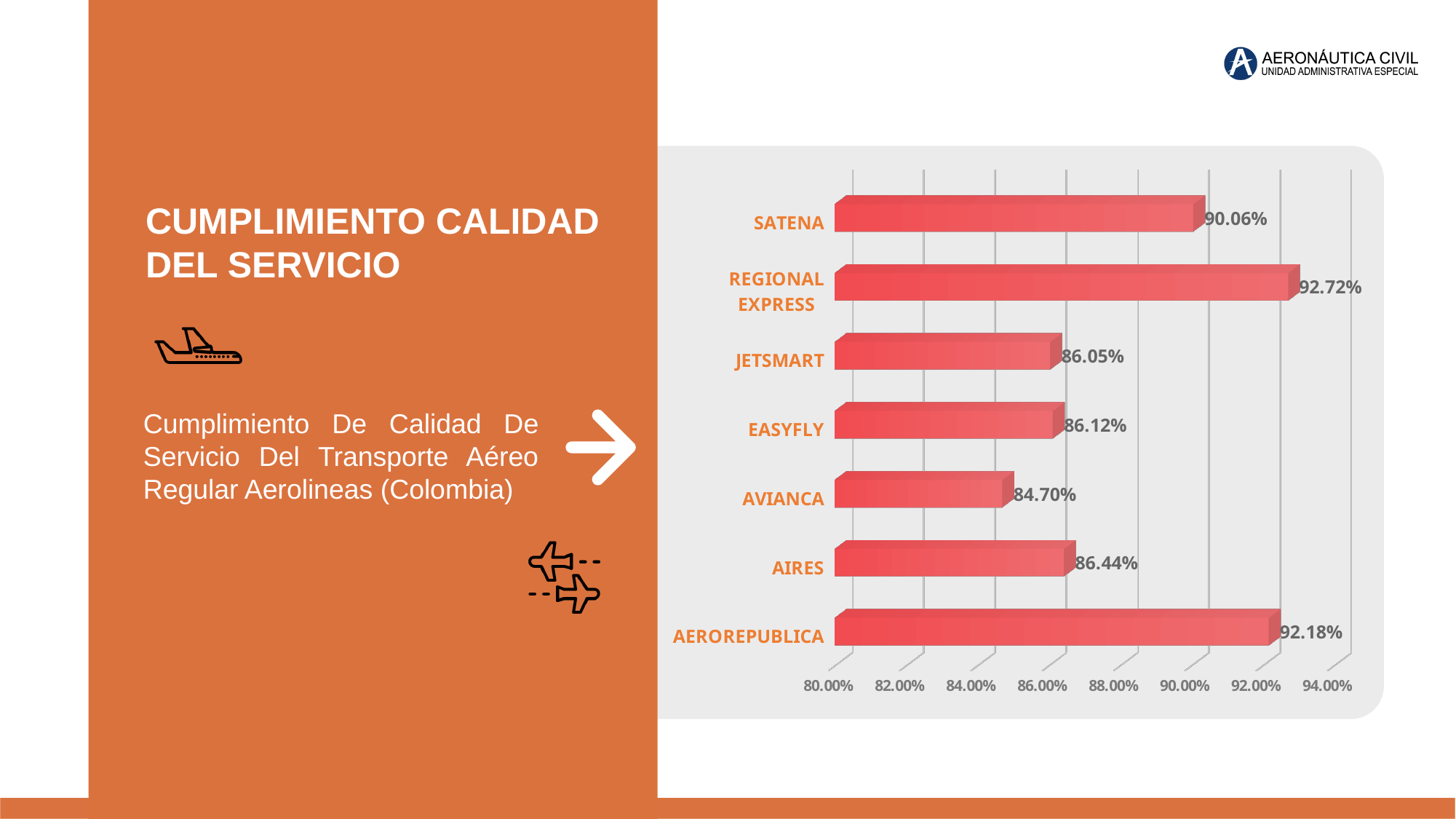
How many airlines are shown in the chart? 7 Which airline has the lowest value? AVIANCA Which airline has the highest value? REGIONAL EXPRESS Which is larger, the value for SATENA or the value for JETSMART? SATENA What is the difference between the values for SATENA and AVIANCA? 5.36% Is the value for AIRES greater or less than 88.00%? less What is the value for AEROREPUBLICA? 92.18% What is the difference between the values for REGIONAL EXPRESS and AEROREPUBLICA? 0.54% What is the value for SATENA? 90.06% What is the value for AVIANCA? 84.70% What is the value for AIRES? 86.44% What kind of chart is shown on the slide? bar chart